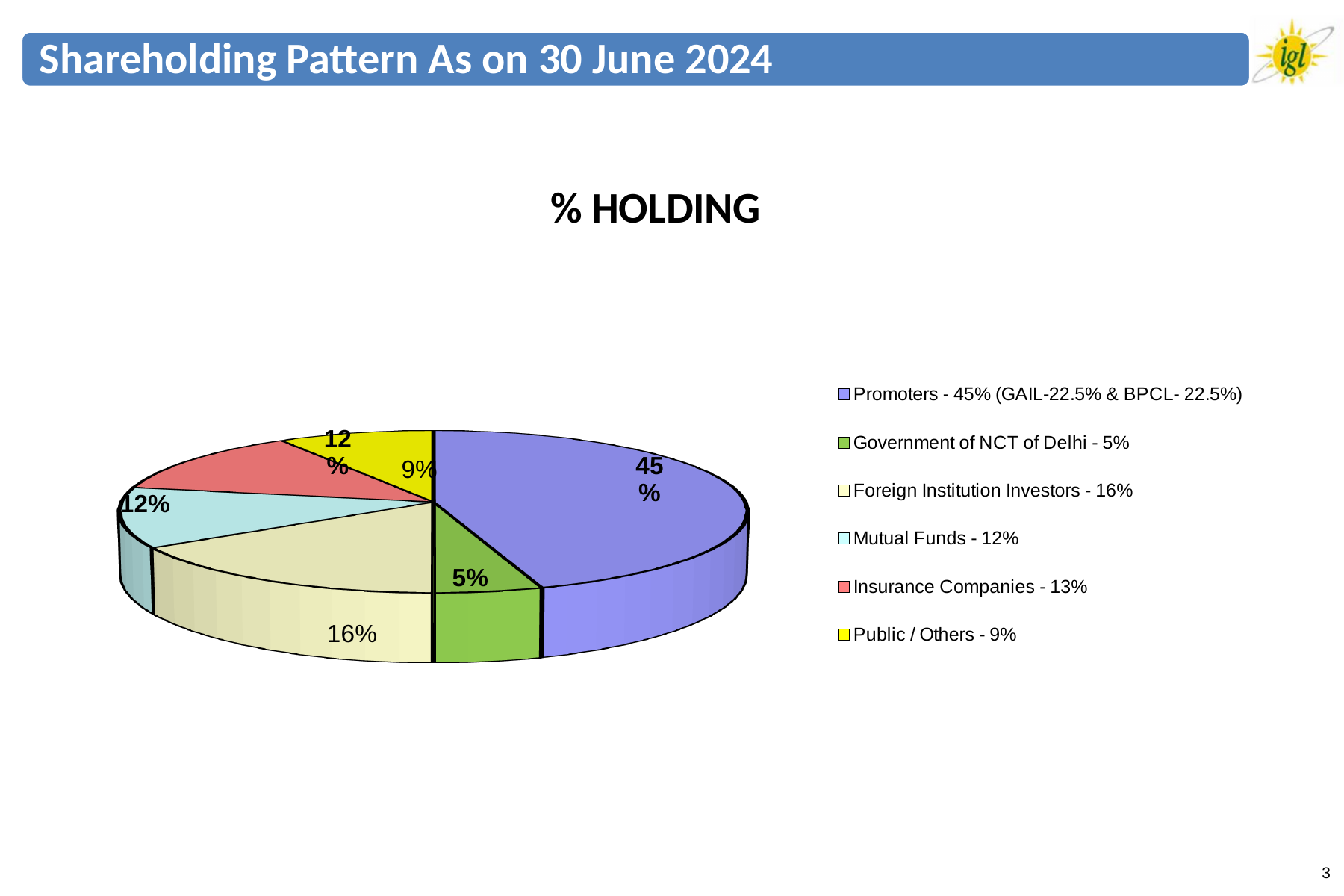
What percentage is held by Mutual Funds? 12% What is the title of the chart? % HOLDING What percentage of holding is attributed to Promoters? 45% Which is larger, the share of Mutual Funds or the share of Public / Others? Mutual Funds What is the share of Foreign Institution Investors? 16% According to the legend, how is the Promoters' 45% split between GAIL and BPCL? GAIL-22.5% & BPCL- 22.5% Which category holds the smallest share of the pie? Government of NCT of Delhi What kind of chart is shown on the slide? Pie chart Which category holds the largest share of the pie? Promoters What is the difference in percentage points between Promoters and Foreign Institution Investors? 29 How many slices does the pie chart have? 6 What is the share of Public / Others? 9%